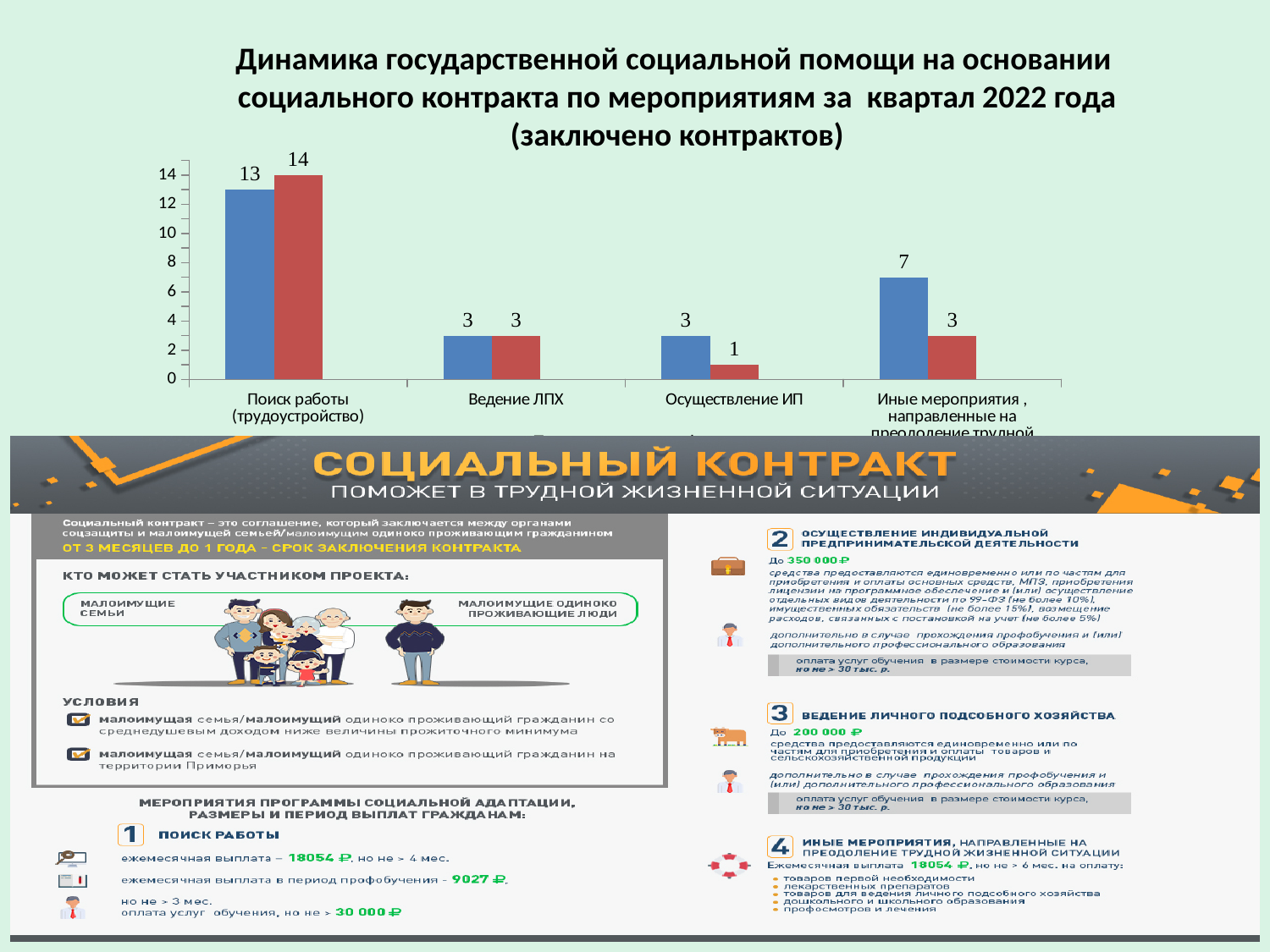
Which category has the highest blue bar? Поиск работы (трудоустройство) What type of chart is shown on the slide? bar chart What are the values of the blue and red bars for Ведение ЛПХ? 3 and 3 Which category has the lowest red bar? Осуществление ИП Which is larger for Поиск работы (трудоустройство): the blue bar or the red bar? the red bar What is the value of the red bar for Осуществление ИП? 1 What is the difference between the blue and red bars for Иные мероприятия, направленные на преодоление трудной жизненной ситуации? 4 What is the value of the red bar for Поиск работы (трудоустройство)? 14 How many categories are shown on the x axis of the chart? 4 What is the value of the blue bar for Осуществление ИП? 3 What is the value of the blue bar for Поиск работы (трудоустройство)? 13 What is the value of the blue bar for Иные мероприятия, направленные на преодоление трудной жизненной ситуации? 7